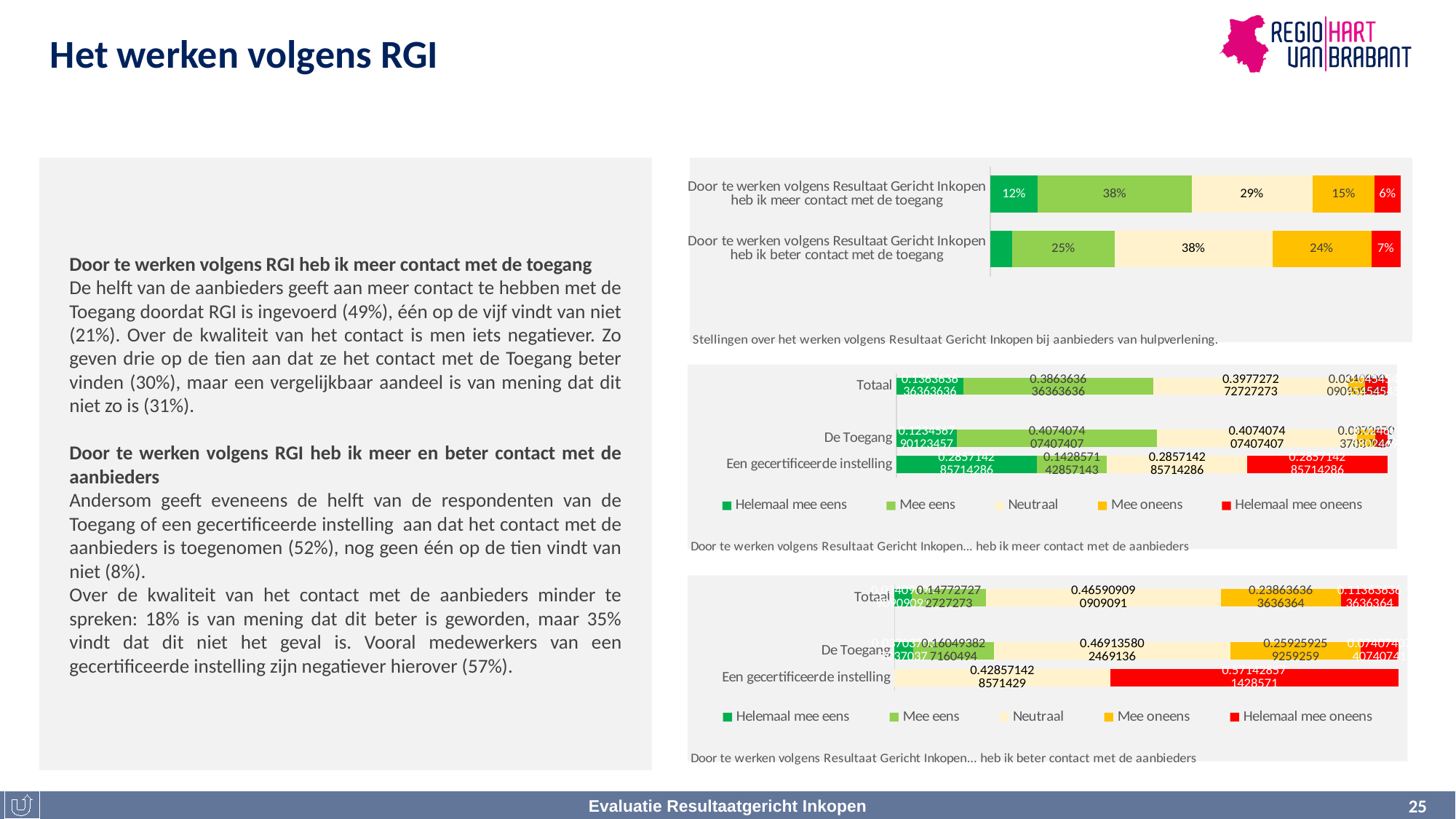
How many categories are shown on the vertical axis of the middle chart ('heb ik meer contact met de aanbieders')? 3 What kind of chart is the top chart about contact with 'de toegang'? bar chart In the top chart, what is the difference between the yellow segments of the 'beter contact' bar (24%) and the 'meer contact' bar (15%)? 9% How many series does the legend of the middle chart ('heb ik meer contact met de aanbieders') list? 5 In the top chart, what is the value of the red segment in the bar 'Door te werken volgens Resultaat Gericht Inkopen heb ik beter contact met de toegang'? 7% In the top chart, what is the value of the yellow segment in the bar 'heb ik beter contact met de toegang'? 24% In the bottom chart ('heb ik beter contact met de aanbieders'), for 'Een gecertificeerde instelling', which segment is larger: Neutraal or Helemaal mee oneens? Helemaal mee oneens What are the legend entries of the bottom chart ('heb ik beter contact met de aanbieders')? Helemaal mee eens, Mee eens, Neutraal, Mee oneens, Helemaal mee oneens How many bars does the top chart show? 2 In the top chart, what is the value of the light green segment in the bar 'Door te werken volgens Resultaat Gericht Inkopen heb ik meer contact met de toegang'? 38% In the top chart, which bar has the larger cream-coloured (neutral) segment: 'meer contact met de toegang' or 'beter contact met de toegang'? heb ik beter contact met de toegang